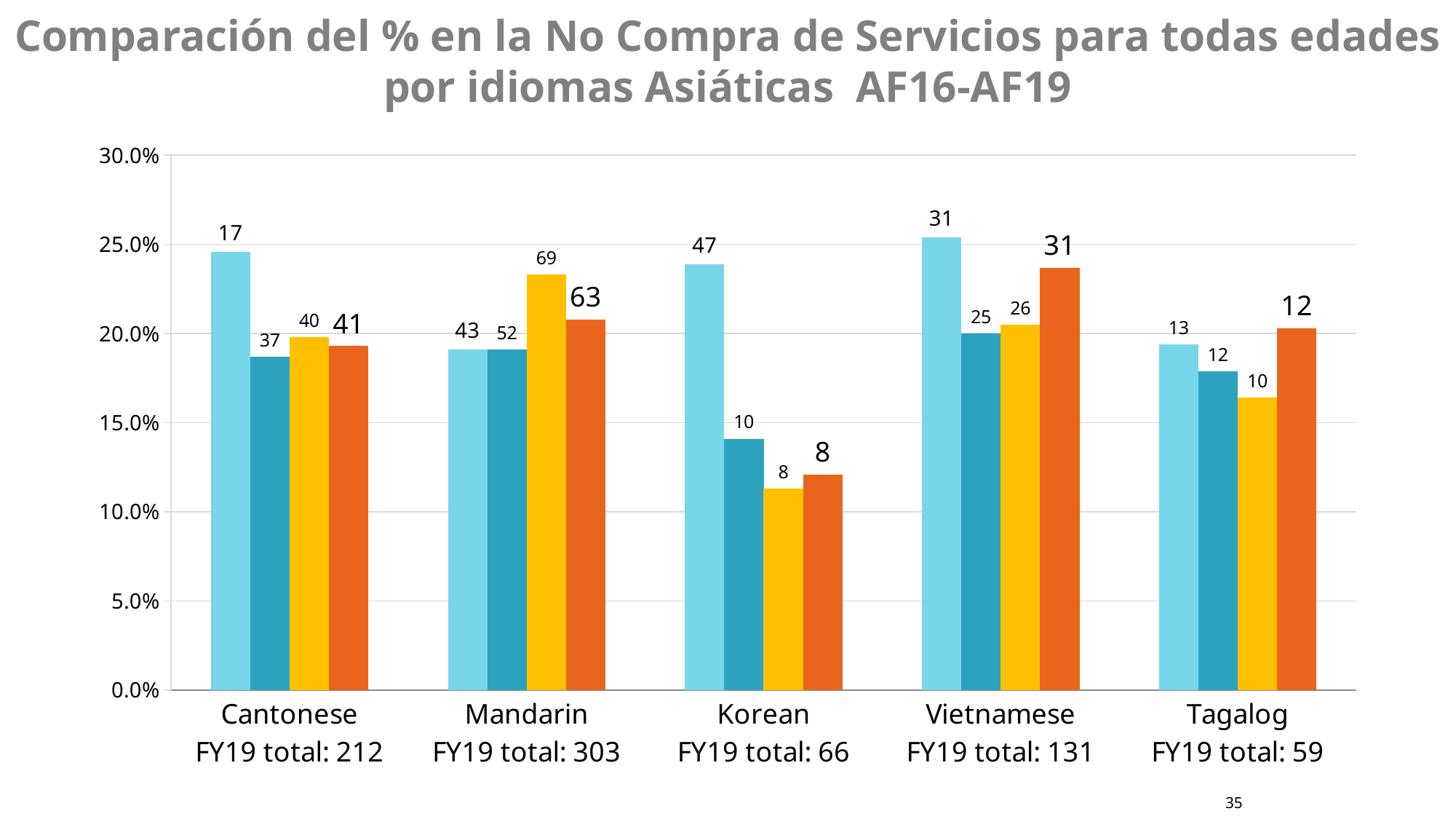
How many language categories are shown on the x axis? 5 What number is printed above the orange (fourth) bar for Mandarin? 63 How many bars are plotted for each language category? 4 What number is printed above the light blue (first) bar for Korean? 47 What FY19 total is shown under the Vietnamese category label? 131 Is the value of the light blue (first) bar for Korean greater or less than 20.0%? greater What number is printed above the yellow (third) bar for Cantonese? 40 Which bar is lower for Korean: the light blue (first) bar or the dark blue (second) bar? the dark blue (second) bar Which language category contains the lowest bar on the chart? Korean Is the value of the dark blue (second) bar for Cantonese greater or less than 20.0%? less What kind of chart is shown on the slide? bar chart Is the value of the yellow (third) bar for Korean greater or less than 15.0%? less